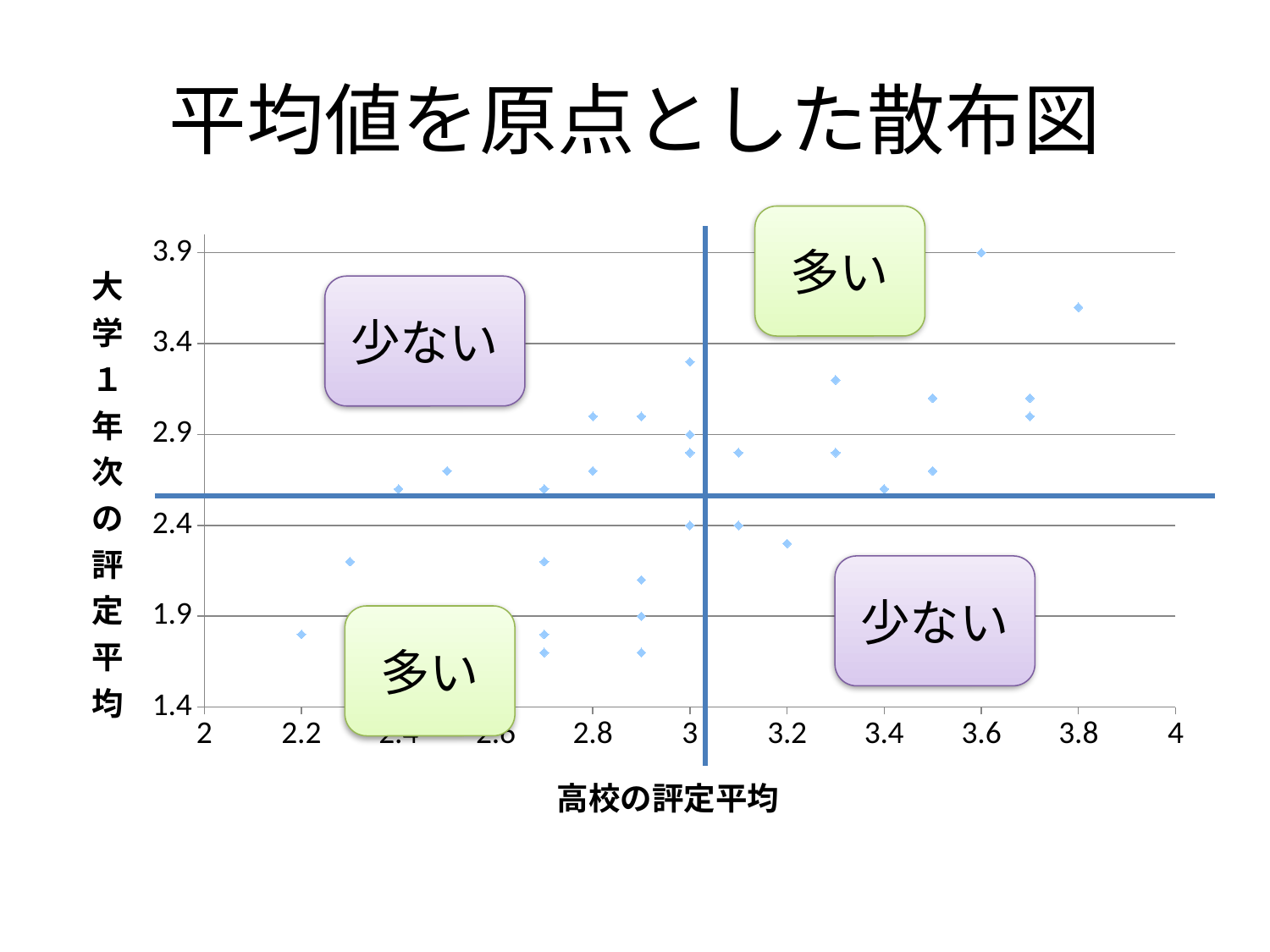
Is the 大学1年次の評定平均 value of the point at 高校の評定平均 3.6 greater or less than 3.4? greater Is the 大学1年次の評定平均 value of the point at 高校の評定平均 3.2 greater or less than 2.4? less At which 高校の評定平均 value does the point with the highest 大学1年次の評定平均 appear? 3.6 What is the label of the horizontal axis of the chart? 高校の評定平均 What is the title of the chart on the slide? 平均値を原点とした散布図 Is the 大学1年次の評定平均 value of the point at 高校の評定平均 2.2 greater or less than 2.4? less Which point has a higher 大学1年次の評定平均: the one at 高校の評定平均 3.6 or the one at 2.2? the one at 3.6 Overall, do the 大学1年次の評定平均 values tend to rise or fall as 高校の評定平均 increases? rise What is the smallest 高校の評定平均 value at which a point is plotted? 2.2 What kind of chart is shown on the slide? scatter plot What is the largest 高校の評定平均 value at which a point is plotted? 3.8